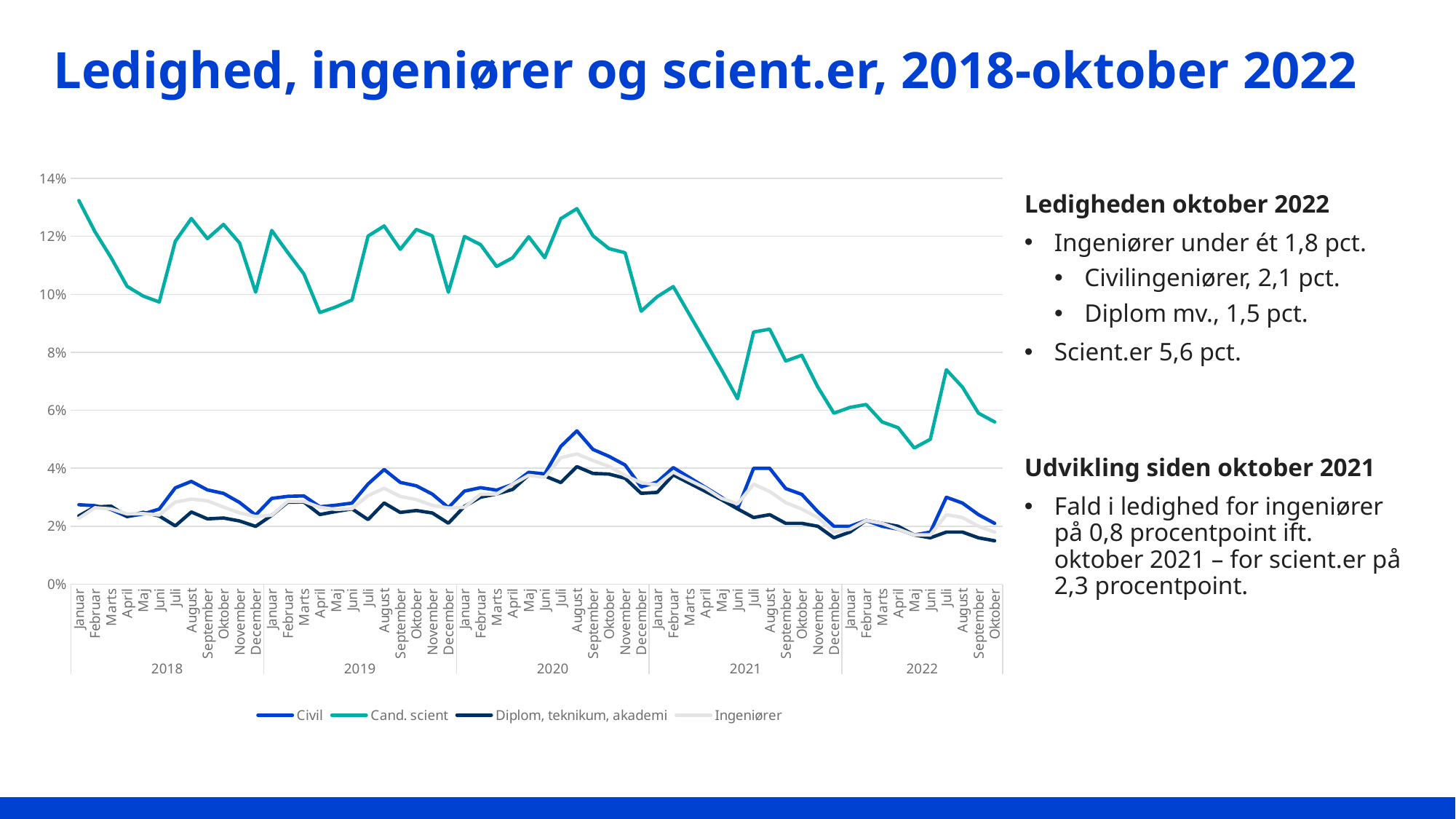
Which series has the lowest value in Oktober 2022? Diplom, teknikum, akademi How many series does the chart legend list? 4 Which series has the highest unemployment rate throughout the whole period? Cand. scient Is the value for Cand. scient in Januar 2018 greater or less than 12%? greater Does the Cand. scient line rise or fall from the start of 2020 to Oktober 2022? Falls What colour is the Cand. scient line in the chart? Teal (green) According to the slide text, what is the unemployment rate for scient.er in oktober 2022? 5,6 pct. What kind of chart is shown on the slide? Line chart How many years are labelled along the x axis of the chart? 5 In August 2020, which is higher: Civil or Diplom, teknikum, akademi? Civil Is the value for Cand. scient in Oktober 2022 greater or less than 6%? less Is the value for Civil in August 2020 greater or less than 4%? greater